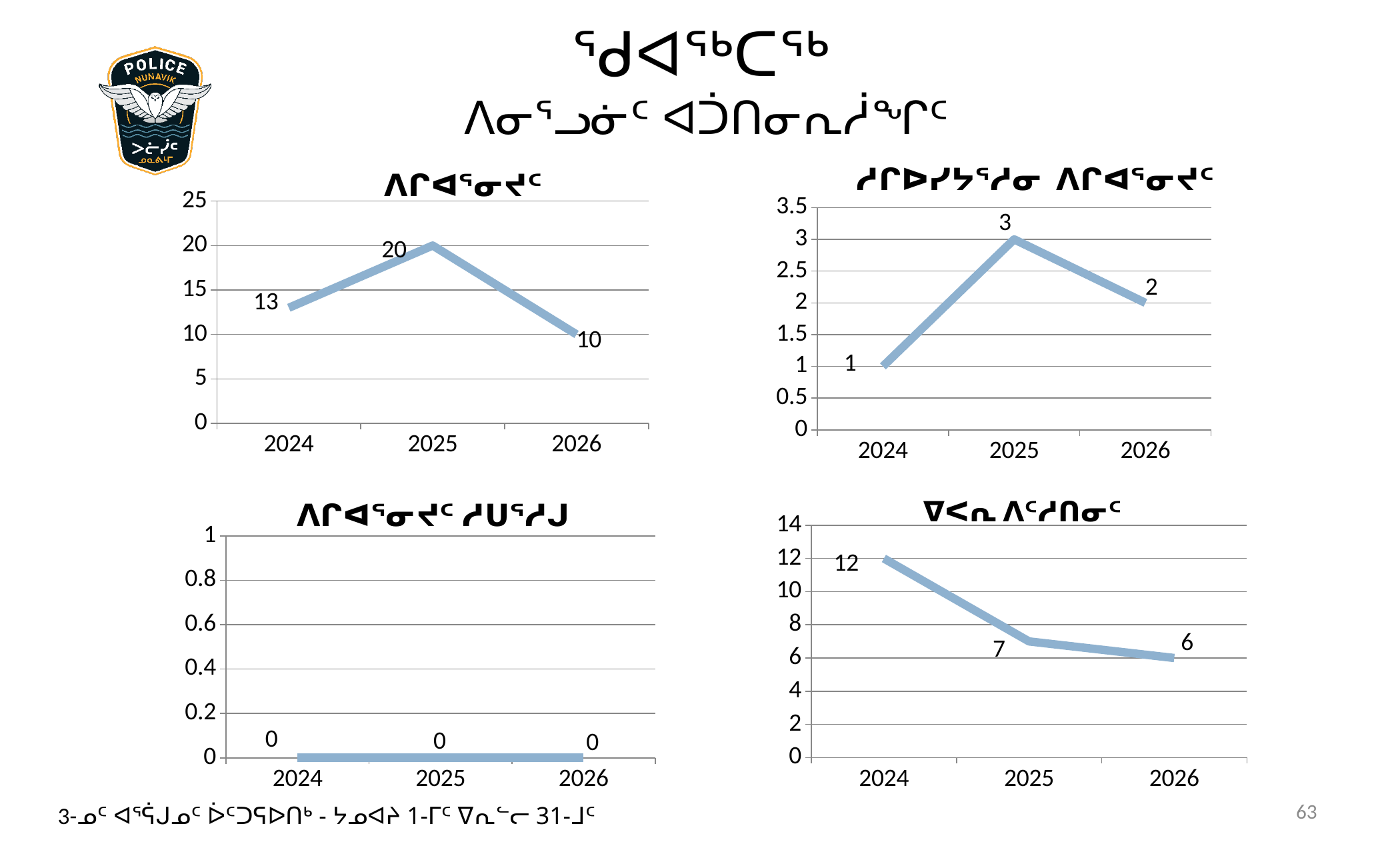
In the top-left chart, what is the value for 2025? 20 In the bottom-right chart, what is the difference between the 2024 and 2026 values? 6 How many data points are plotted in the bottom-right chart? 3 In the top-right chart, what is the value for 2026? 2 What kind of chart is the top-left chart? line chart In the top-left chart, which year has the lowest value? 2026 In the bottom-right chart, what is the value for 2024? 12 In the bottom-right chart, do the values rise or fall from 2024 to 2026? fall In the top-right chart, which year has the highest value? 2025 In the top-right chart, is the value for 2024 larger or smaller than the value for 2026? smaller In the top-left chart, what is the difference between the 2025 and 2024 values? 7 In the bottom-left chart, what is the value for 2025? 0